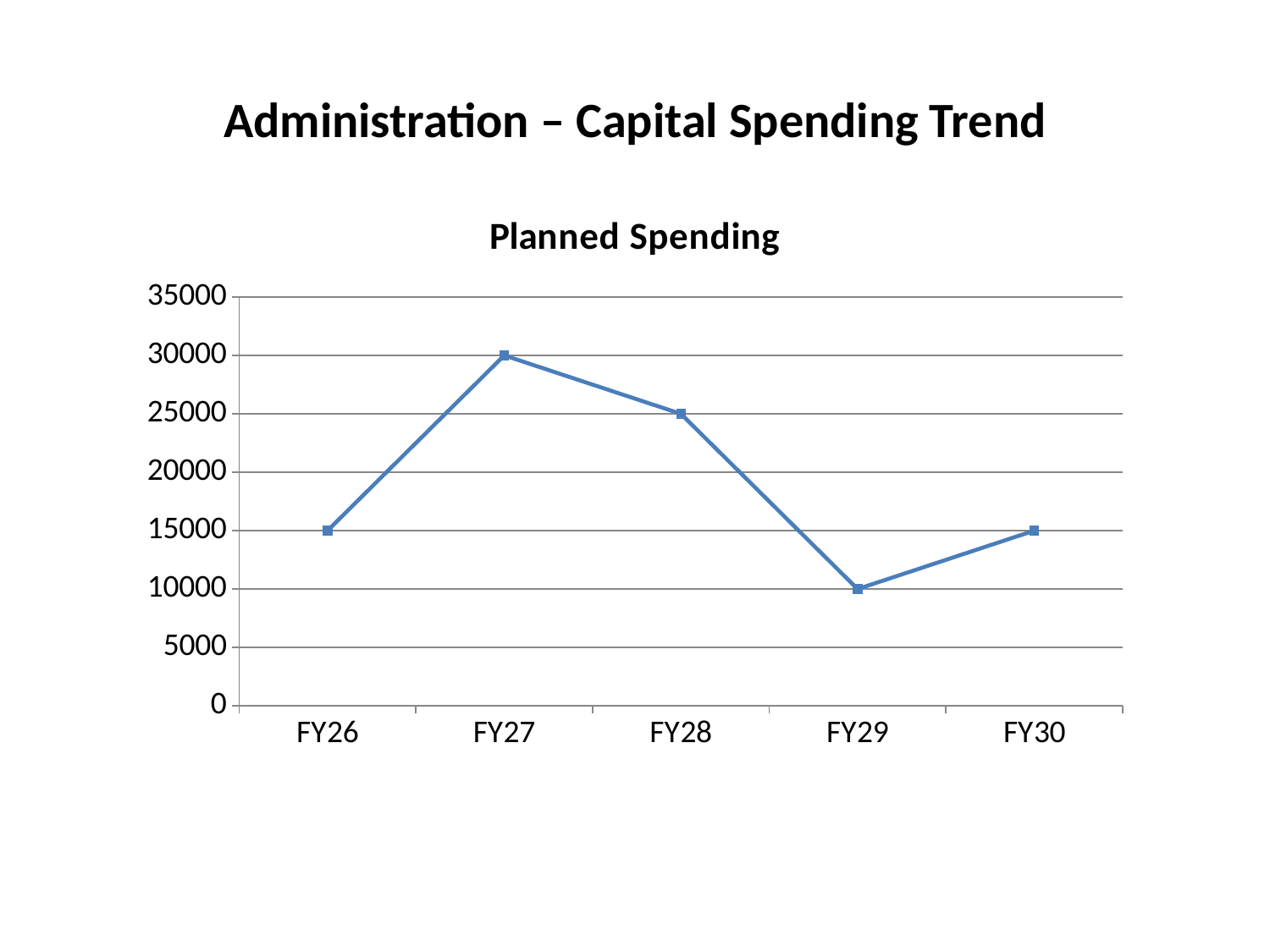
How many fiscal years are plotted on the chart? 5 What is the planned spending value for FY29? 10000 Does planned spending rise or fall from FY27 to FY29? fall Which fiscal year has the highest planned spending? FY27 What is the difference between the planned spending for FY27 and FY29? 20000 Is the value for FY26 greater or less than 20000? less Which is larger, the planned spending for FY28 or FY30? FY28 What type of chart is shown on the slide? line chart What is the planned spending value for FY27? 30000 What is the planned spending value for FY28? 25000 What is the title of the chart? Planned Spending Which fiscal year has the lowest planned spending? FY29